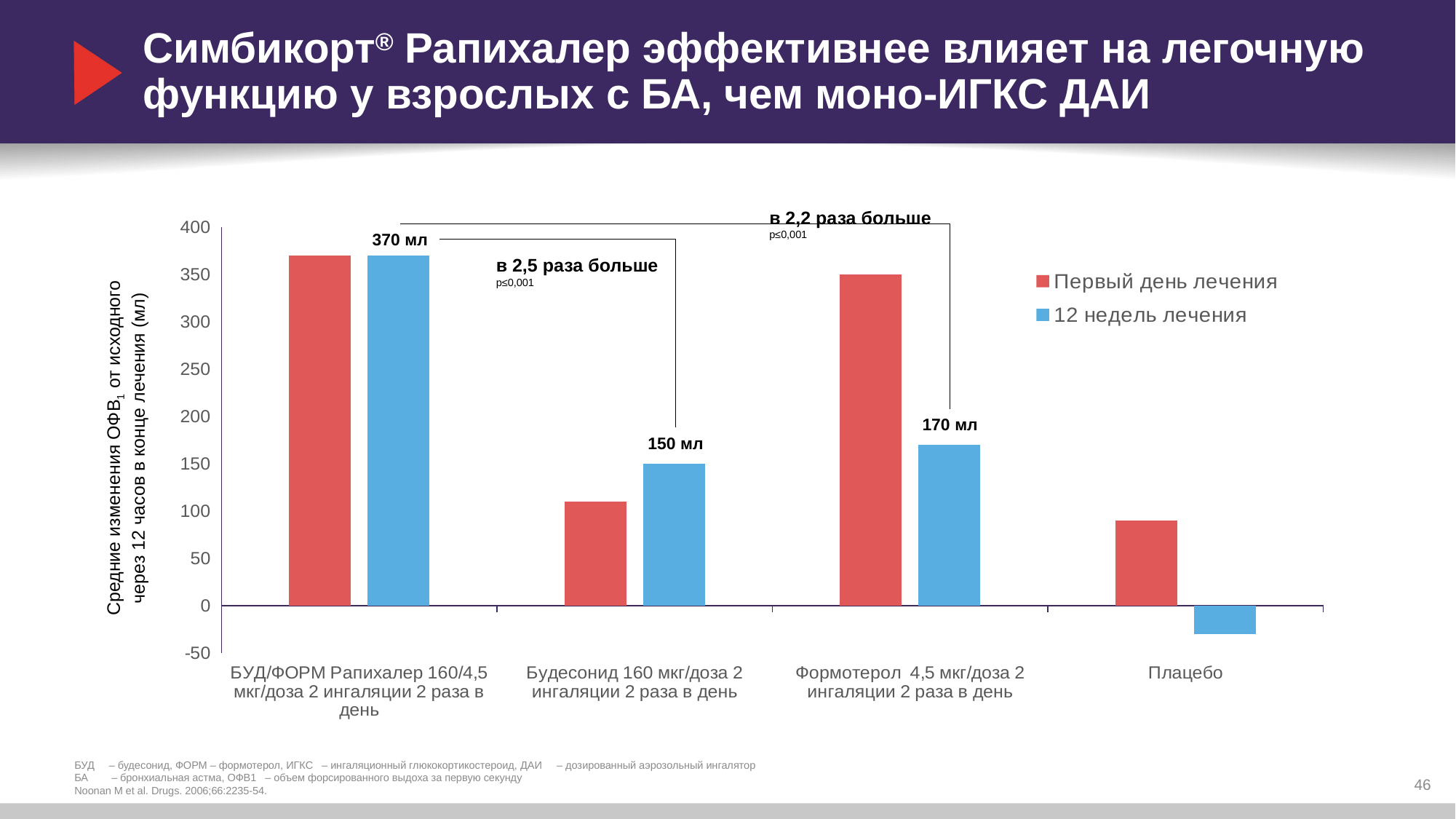
Is the Первый день лечения value for Будесонид 160 мкг/доза greater or less than 150? less What is the difference between the 12 недель лечения values for БУД/ФОРМ Рапихалер and Будесонид? 220 мл What is the value for Формотерол 4,5 мкг/доза in the 12 недель лечения series? 170 мл How many categories are shown on the x axis? 4 Which category has the highest value in the 12 недель лечения series? БУД/ФОРМ Рапихалер 160/4,5 мкг/доза 2 ингаляции 2 раза в день What is the difference between the 12 недель лечения values for БУД/ФОРМ Рапихалер and Формотерол? 200 мл What is the value for БУД/ФОРМ Рапихалер 160/4,5 мкг/доза in the 12 недель лечения series? 370 мл What is the value for Будесонид 160 мкг/доза in the 12 недель лечения series? 150 мл How many series does the legend list? 2 Which category has the lowest value in the 12 недель лечения series? Плацебо Is the Первый день лечения value for Формотерол 4,5 мкг/доза greater or less than 300? greater In the 12 недель лечения series, which is larger: Будесонид or Формотерол? Формотерол